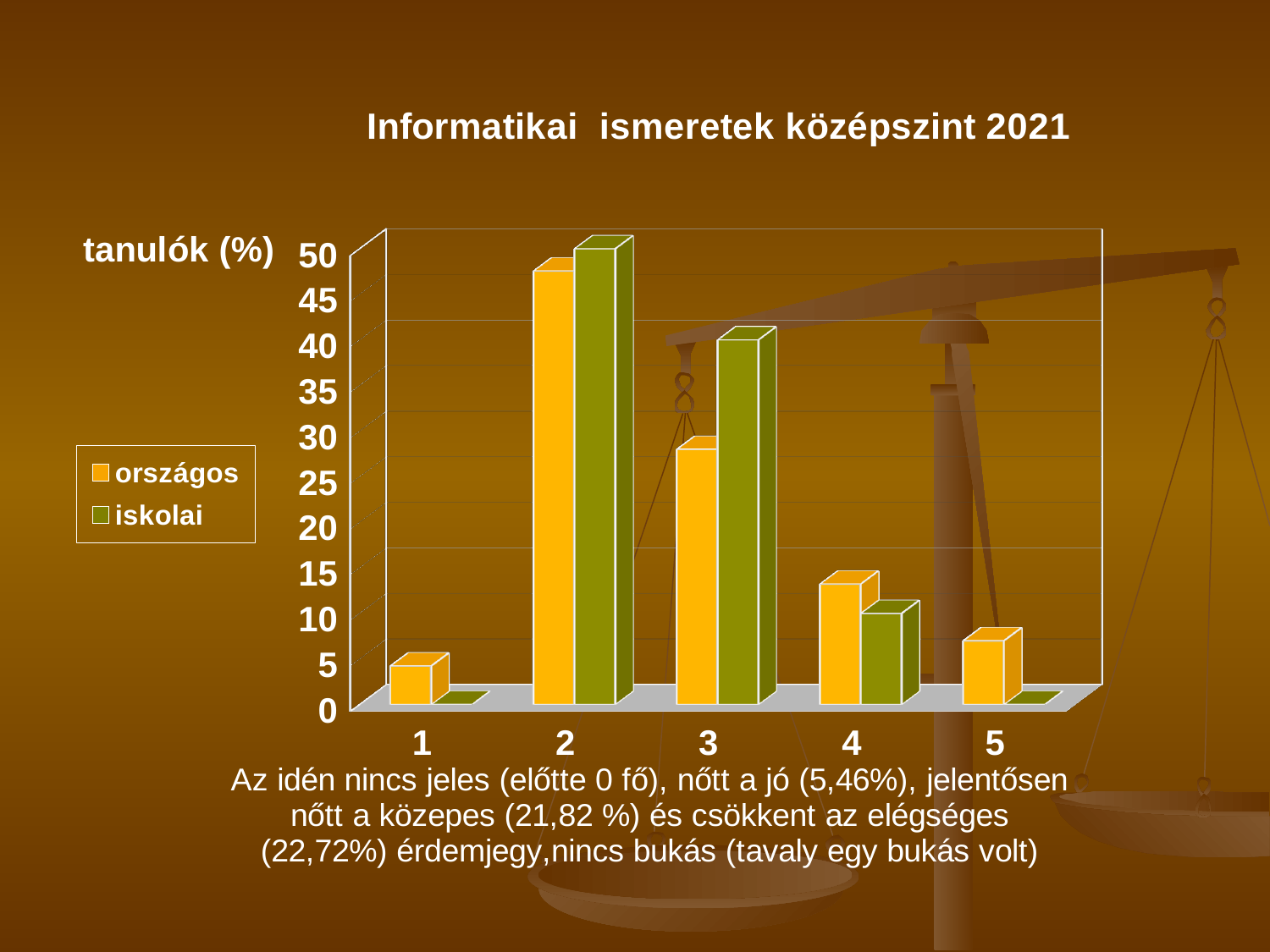
For category 4, which series has the larger value, országos or iskolai? országos How many series does the legend list? 2 For which category is the országos series lowest? 1 Is the országos value for category 3 greater or less than 30? less What are the two series named in the legend? országos, iskolai Is the országos value for category 2 greater or less than 45? greater For which category is the iskolai series highest? 2 For category 3, which series has the larger value, országos or iskolai? iskolai For which category is the országos series highest? 2 How many categories are shown on the x axis? 5 What is the title of the chart? Informatikai ismeretek középszint 2021 What kind of chart is shown on the slide? bar chart